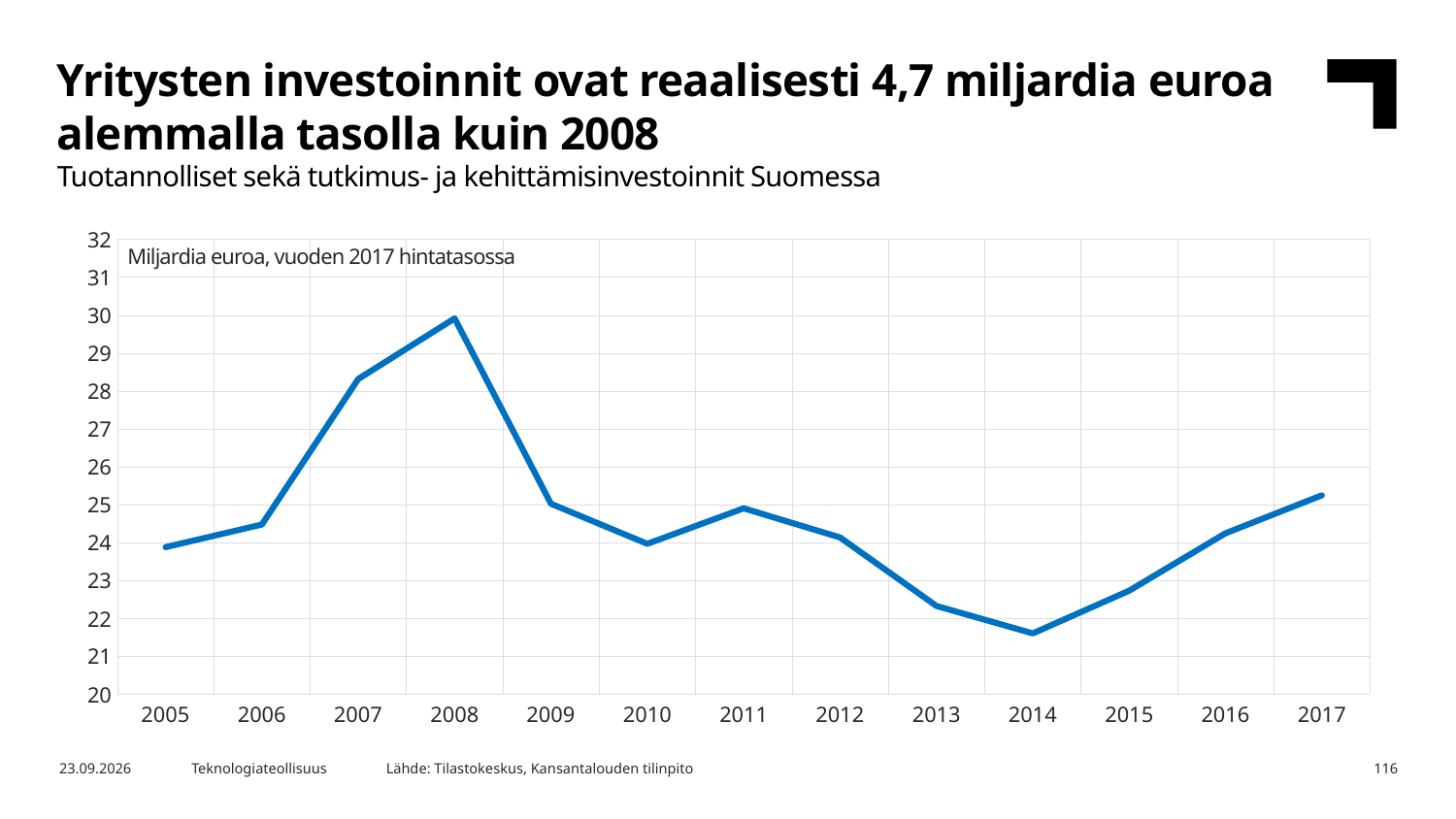
Is the value for 2013 greater or less than 23? less Do the values rise or fall from 2008 to 2014? fall Which year has the larger value, 2007 or 2009? 2007 What kind of chart is shown on the slide? line chart In which year is the investment value highest? 2008 Is the value for 2008 greater or less than 29? greater Is the value for 2014 greater or less than 22? less What unit label is printed inside the chart area? Miljardia euroa, vuoden 2017 hintatasossa In which year is the investment value lowest? 2014 How many years are plotted on the x axis? 13 Which year has the larger value, 2013 or 2016? 2016